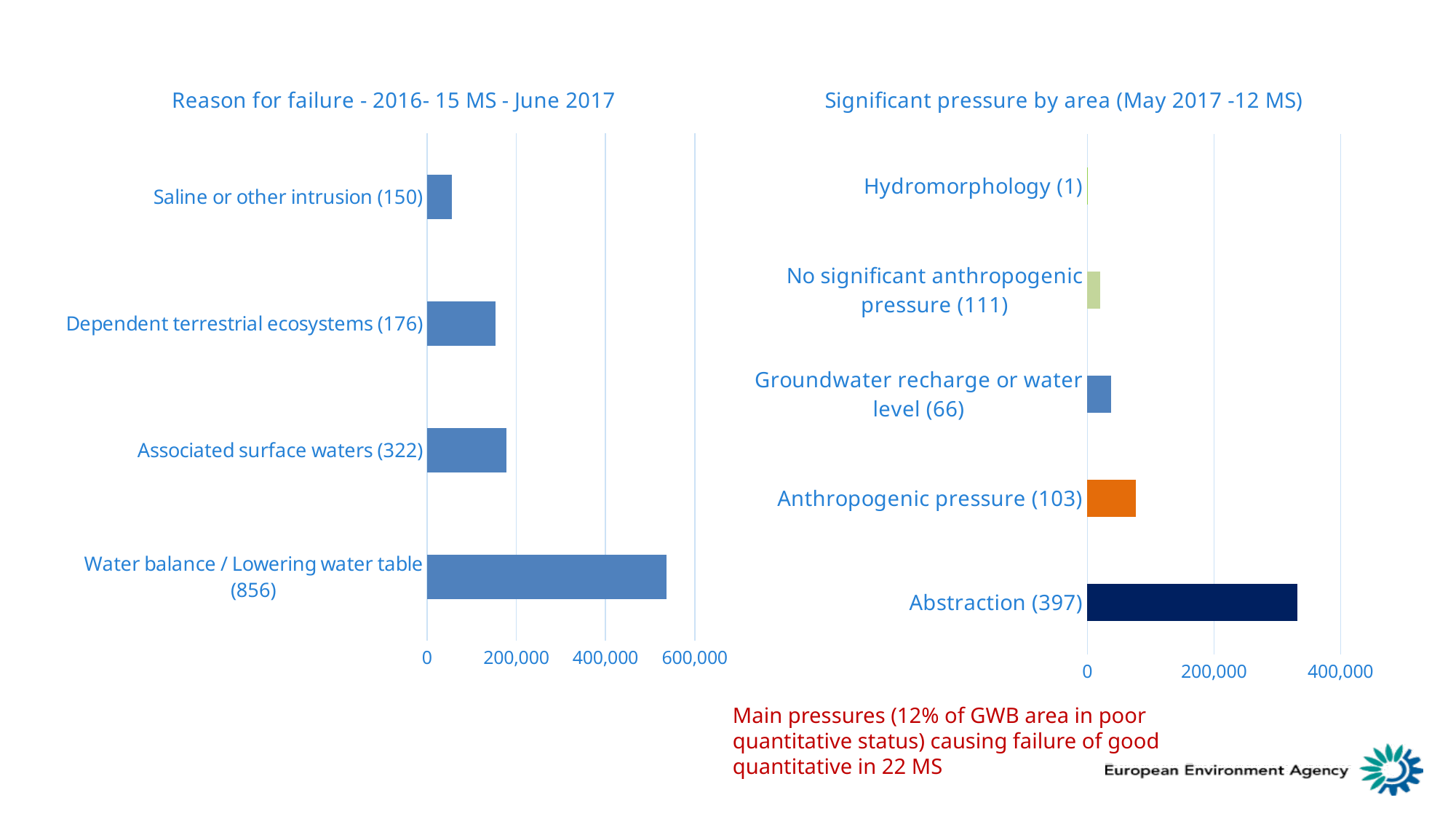
How many categories are shown in the 'Reason for failure - 2016- 15 MS - June 2017' chart? 4 In the 'Reason for failure - 2016- 15 MS - June 2017' chart, is the value for Associated surface waters greater or less than 200,000? less In the 'Reason for failure - 2016- 15 MS - June 2017' chart, which category has the lowest value? Saline or other intrusion (150) In the 'Significant pressure by area (May 2017 -12 MS)' chart, is the value for Abstraction greater or less than 200,000? greater In the 'Significant pressure by area (May 2017 -12 MS)' chart, which category has the highest value? Abstraction (397) In the 'Reason for failure - 2016- 15 MS - June 2017' chart, is the value for Water balance / Lowering water table greater or less than 400,000? greater What kind of chart is the 'Reason for failure - 2016- 15 MS - June 2017' chart? bar chart How many categories are shown in the 'Significant pressure by area (May 2017 -12 MS)' chart? 5 In the 'Significant pressure by area (May 2017 -12 MS)' chart, which category is larger: Anthropogenic pressure or Groundwater recharge or water level? Anthropogenic pressure In the 'Significant pressure by area (May 2017 -12 MS)' chart, which category has the lowest value? Hydromorphology (1) In the 'Reason for failure - 2016- 15 MS - June 2017' chart, which category has the highest value? Water balance / Lowering water table (856)